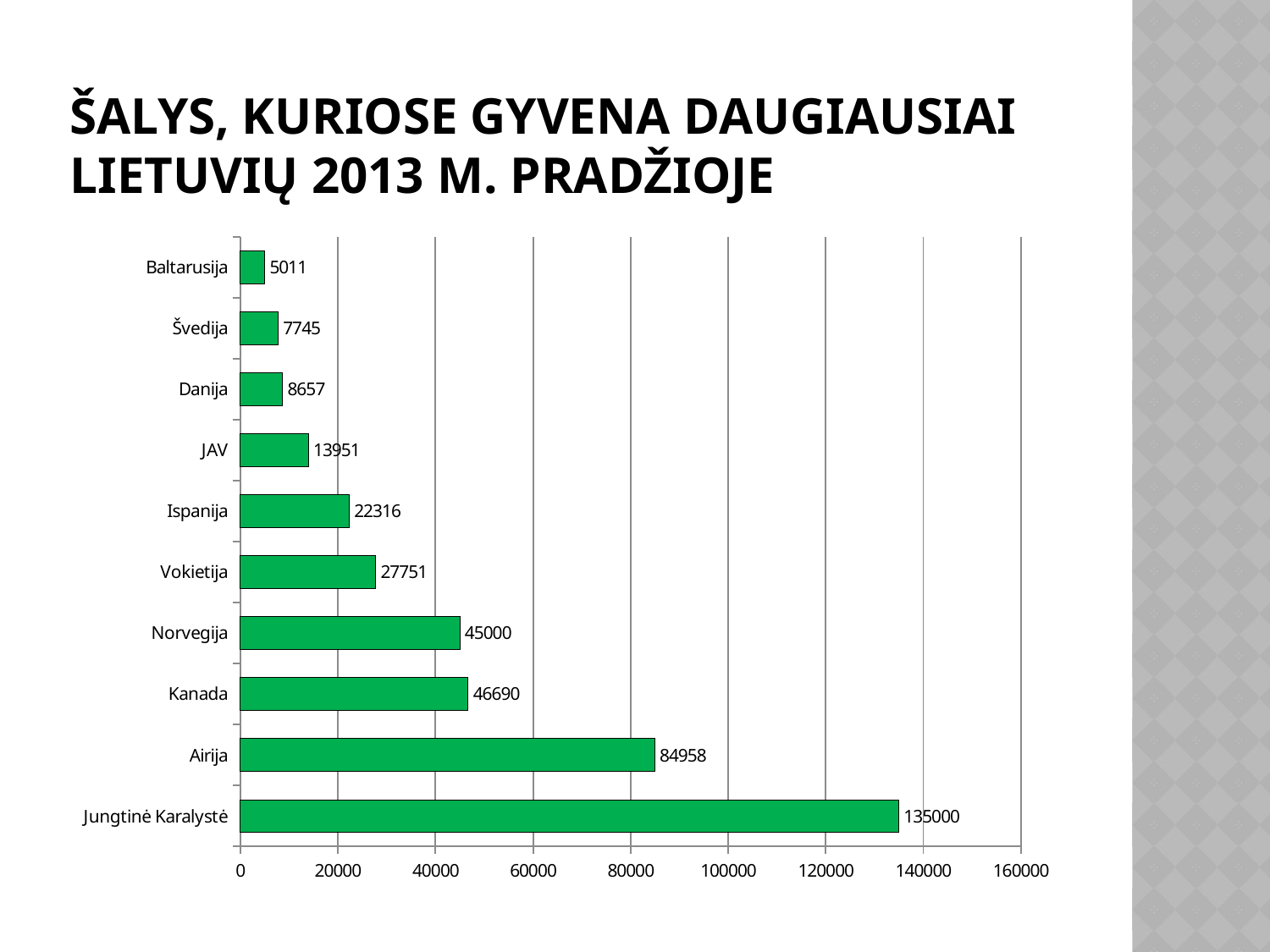
Which country has the highest value? Jungtinė Karalystė What is the difference between the values for Jungtinė Karalystė and Airija? 50042 Is the value for Airija greater or less than 80000? greater What is the value for Airija? 84958 What is the value for Baltarusija? 5011 What is the difference between the values for Kanada and Norvegija? 1690 How many countries are shown in the chart? 10 What is the maximum value shown on the horizontal axis? 160000 Which is larger, the value for Ispanija or the value for Vokietija? Vokietija Which country has the lowest value? Baltarusija What kind of chart is shown on the slide? bar chart What is the value for Norvegija? 45000